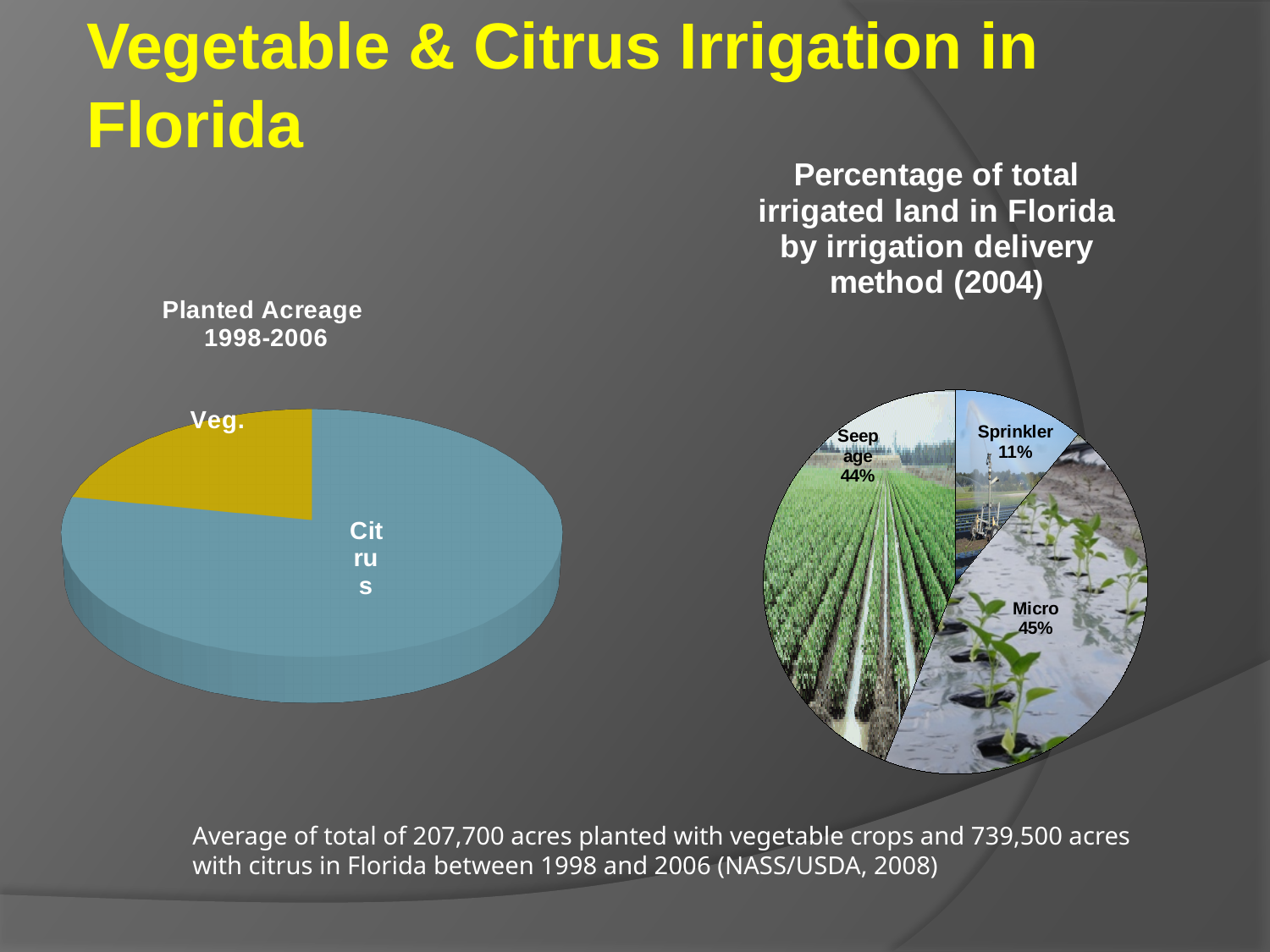
In the 'Percentage of total irrigated land in Florida by irrigation delivery method (2004)' chart, what is the difference between the Micro and Sprinkler shares? 34% What kind of chart is the 'Planted Acreage 1998-2006' chart? Pie chart In the 'Planted Acreage 1998-2006' chart, which slice is larger, Citrus or Veg.? Citrus In the 'Percentage of total irrigated land in Florida by irrigation delivery method (2004)' chart, what share does Sprinkler have? 11% In the 'Percentage of total irrigated land in Florida by irrigation delivery method (2004)' chart, what share does Seepage have? 44% In the 'Percentage of total irrigated land in Florida by irrigation delivery method (2004)' chart, how many irrigation methods are shown? 3 What kind of chart is the 'Percentage of total irrigated land in Florida by irrigation delivery method (2004)' chart? Pie chart In the 'Percentage of total irrigated land in Florida by irrigation delivery method (2004)' chart, what share does Micro have? 45% In the 'Percentage of total irrigated land in Florida by irrigation delivery method (2004)' chart, which share is larger, Seepage or Sprinkler? Seepage In the 'Planted Acreage 1998-2006' chart, which category has the largest slice? Citrus In the 'Percentage of total irrigated land in Florida by irrigation delivery method (2004)' chart, which irrigation method has the smallest share? Sprinkler In the 'Planted Acreage 1998-2006' chart, how many slices are there? 2